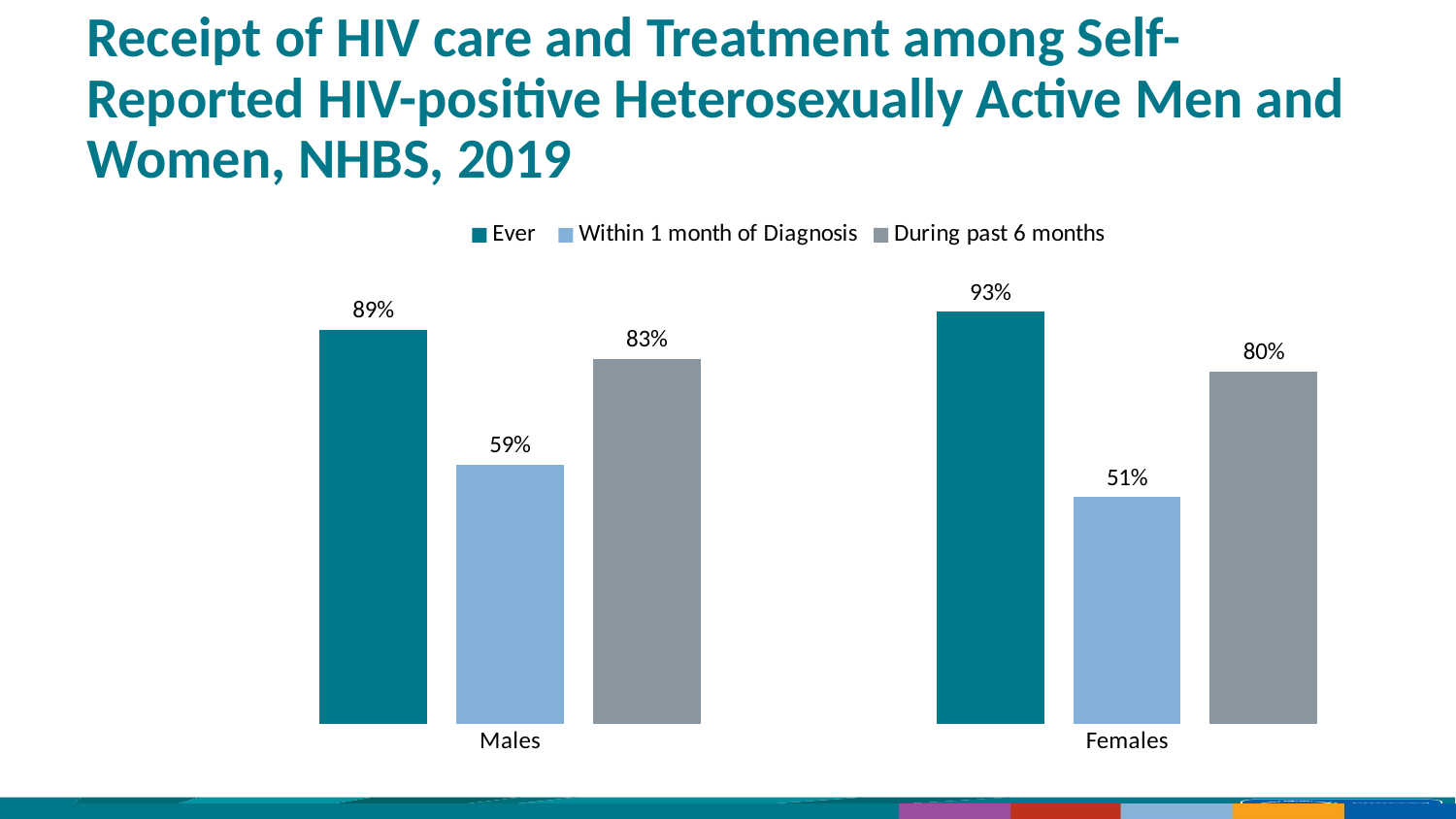
How many categories are shown on the x axis? 2 How many series does the legend list? 3 Which category has the higher value in the Ever series? Females What is the value for Males in the Ever series? 89% What is the difference between the Within 1 month of Diagnosis values for Males and Females? 8% Is the During past 6 months value larger for Males or Females? Males What is the value for Males in the During past 6 months series? 83% What is the value for Females in the Within 1 month of Diagnosis series? 51% Which series has the lowest value for Males? Within 1 month of Diagnosis What is the value for Females in the During past 6 months series? 80% What is the difference between the Ever values for Females and Males? 4% What kind of chart is shown on the slide? Bar chart